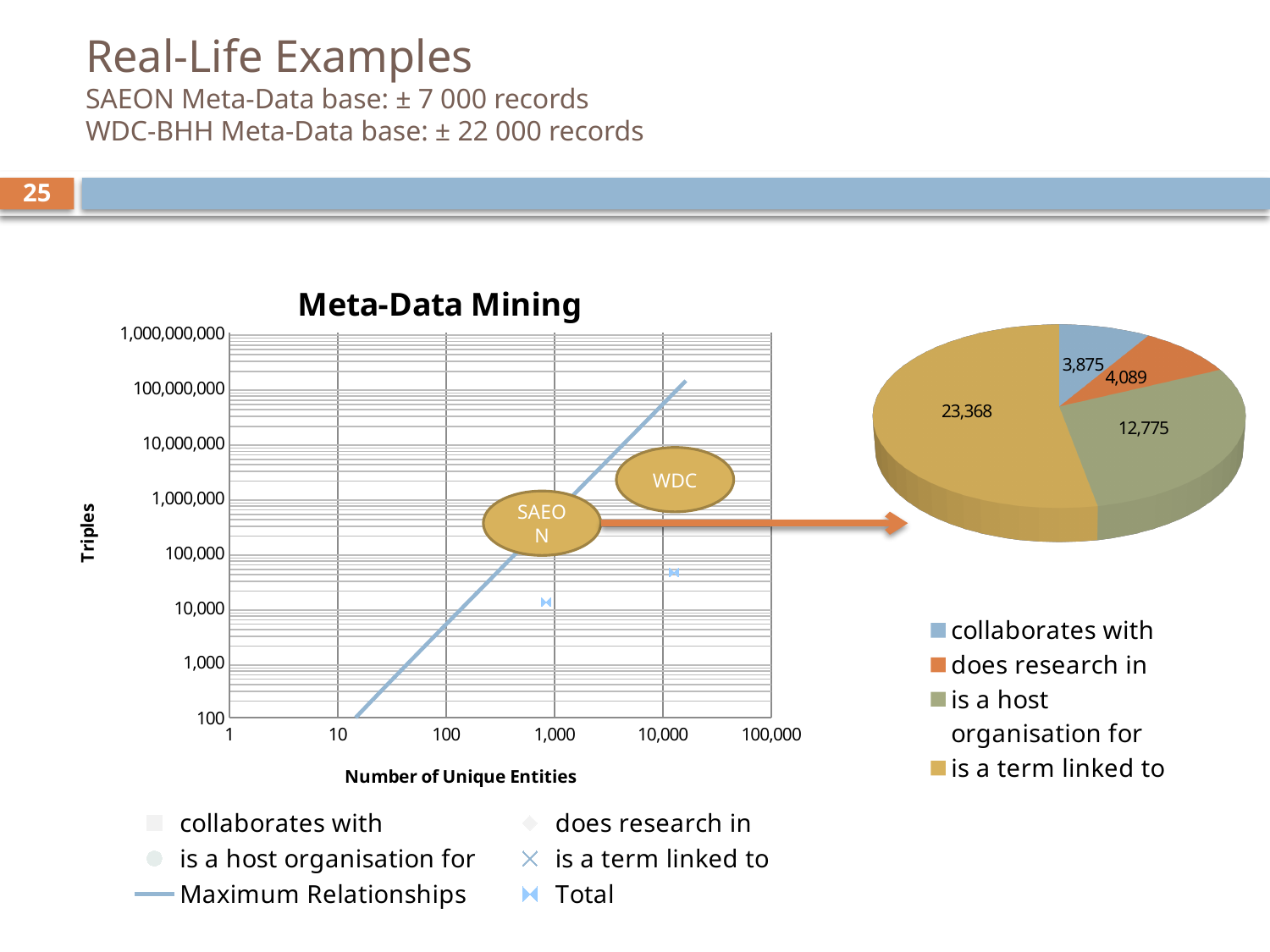
How many series does the legend of the Meta-Data Mining chart list? 6 In the pie chart, which category has the smallest slice? collaborates with What is the title of the y axis of the Meta-Data Mining chart? Triples In the pie chart, what is the difference between "is a host organisation for" and "does research in"? 8,686 In the pie chart, which category has the largest slice? is a term linked to In the pie chart, what is the value for "is a host organisation for"? 12,775 In the pie chart, what is the value for "is a term linked to"? 23,368 In the pie chart, which is larger: "collaborates with" or "does research in"? does research in In the pie chart, what is the total of all four slices? 44,107 In the Meta-Data Mining chart, is the Triples value of the lower-left Total marker greater or less than 100,000? less How many slices does the pie chart have? 4 In the pie chart, what is the value for "does research in"? 4,089